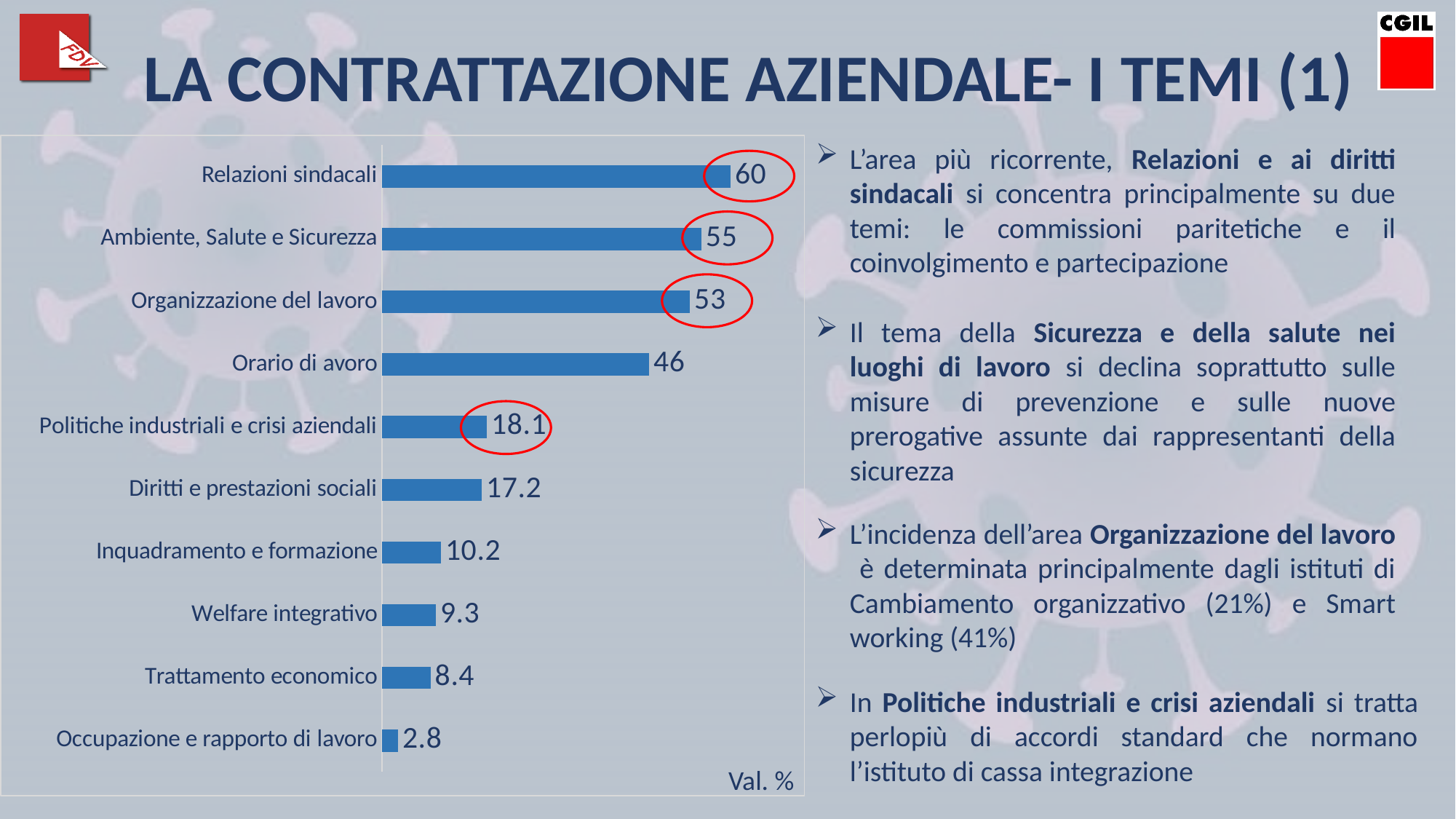
What kind of chart is shown on the slide? Bar chart Which category has the lowest value? Occupazione e rapporto di lavoro How many data labels on the chart are circled in red? 4 What is the difference between the values for Ambiente, Salute e Sicurezza and Organizzazione del lavoro? 2 How many categories are shown in the chart? 10 What is the value for Relazioni sindacali? 60 What is the value for Politiche industriali e crisi aziendali? 18.1 Which is larger, the value for Diritti e prestazioni sociali or the value for Inquadramento e formazione? Diritti e prestazioni sociali What is the difference between the values for Orario di avoro and Trattamento economico? 37.6 What is the value for Welfare integrativo? 9.3 What unit label is shown at the bottom right of the chart? Val. % Which category has the highest value? Relazioni sindacali